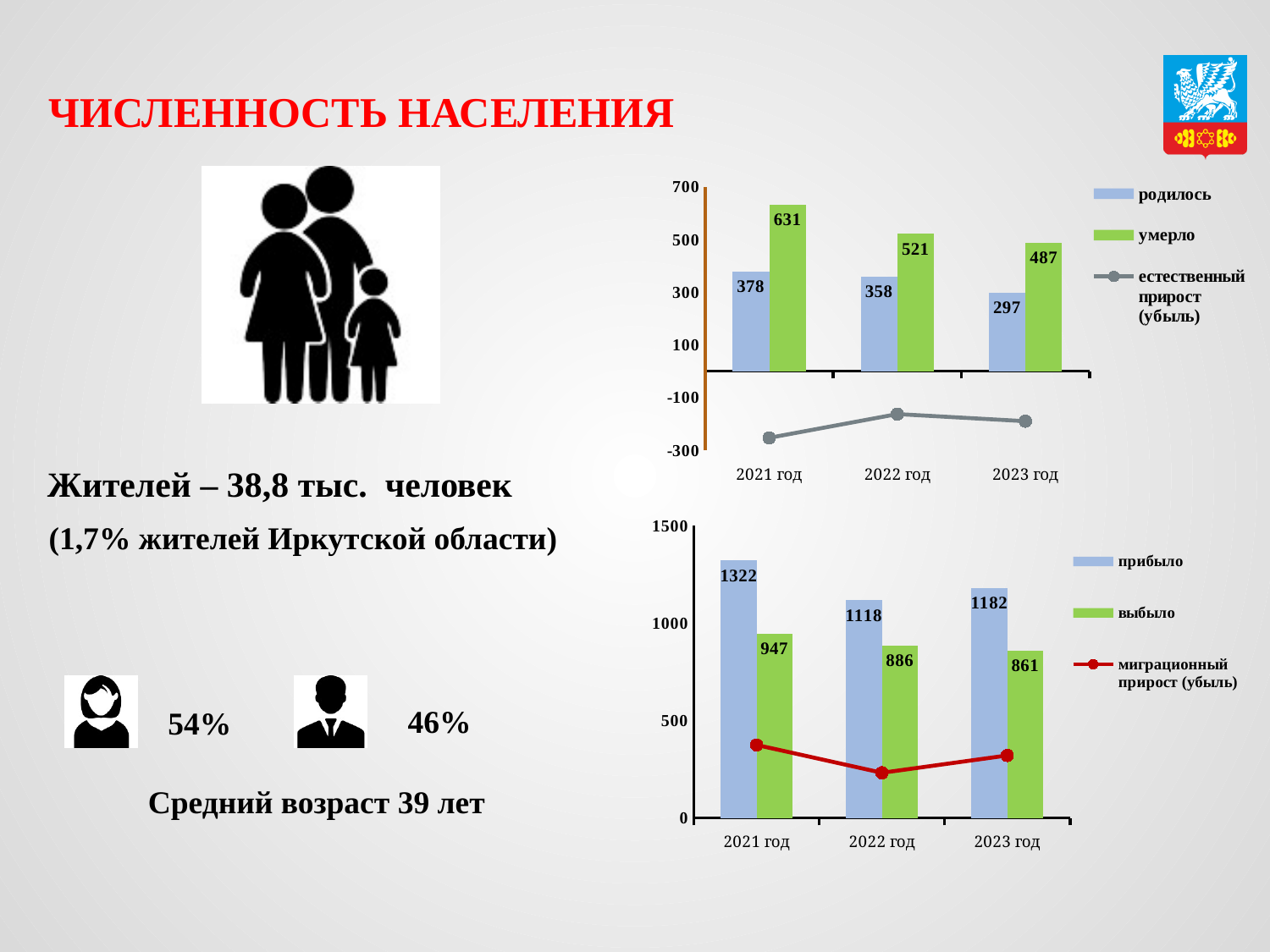
In the top chart, is the value for естественный прирост (убыль) in 2022 год greater or less than -100? less In the bottom chart, what is the value for выбыло in 2021 год? 947 In the top chart, what is the value for родилось in 2021 год? 378 In the bottom chart, what is the difference between прибыло and выбыло in 2023 год? 321 How many years are shown on the x axis of the bottom chart? 3 How many series does the legend of the top chart list? 3 In the bottom chart, what is the value for прибыло in 2022 год? 1118 In the top chart, what is the value for умерло in 2023 год? 487 In the top chart, what is the difference between умерло and родилось in 2021 год? 253 In the bottom chart, which is larger in 2022 год: прибыло or выбыло? прибыло In the bottom chart, which year has the highest value for прибыло? 2021 год In the top chart, do the values for родилось rise or fall from 2021 год to 2023 год? fall